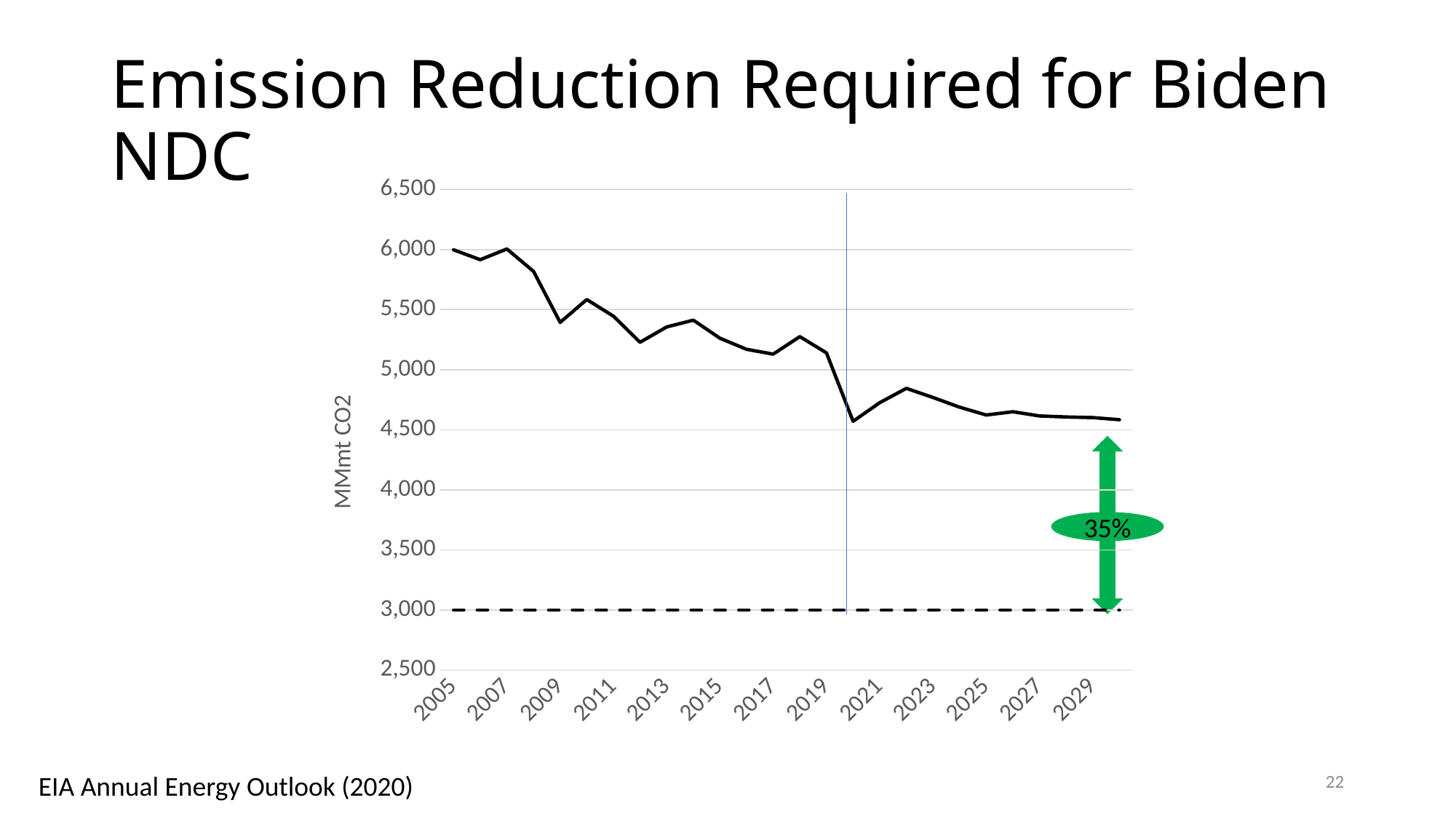
Is the value for 2005 greater or less than 5,500? greater What is the label of the y axis? MMmt CO2 Which year has the larger value, 2005 or 2029? 2005 Is the value for 2021 greater or less than 5,000? less At what level on the y axis is the dashed horizontal line drawn? 3,000 Is the value for 2013 greater or less than 5,000? greater Which year has the larger value, 2017 or 2025? 2017 What percentage is printed on the green arrow? 35% Do the plotted emission values generally rise or fall from 2005 to 2029? fall What is the title of the chart on the slide? Emission Reduction Required for Biden NDC What kind of chart is shown on the slide? line chart